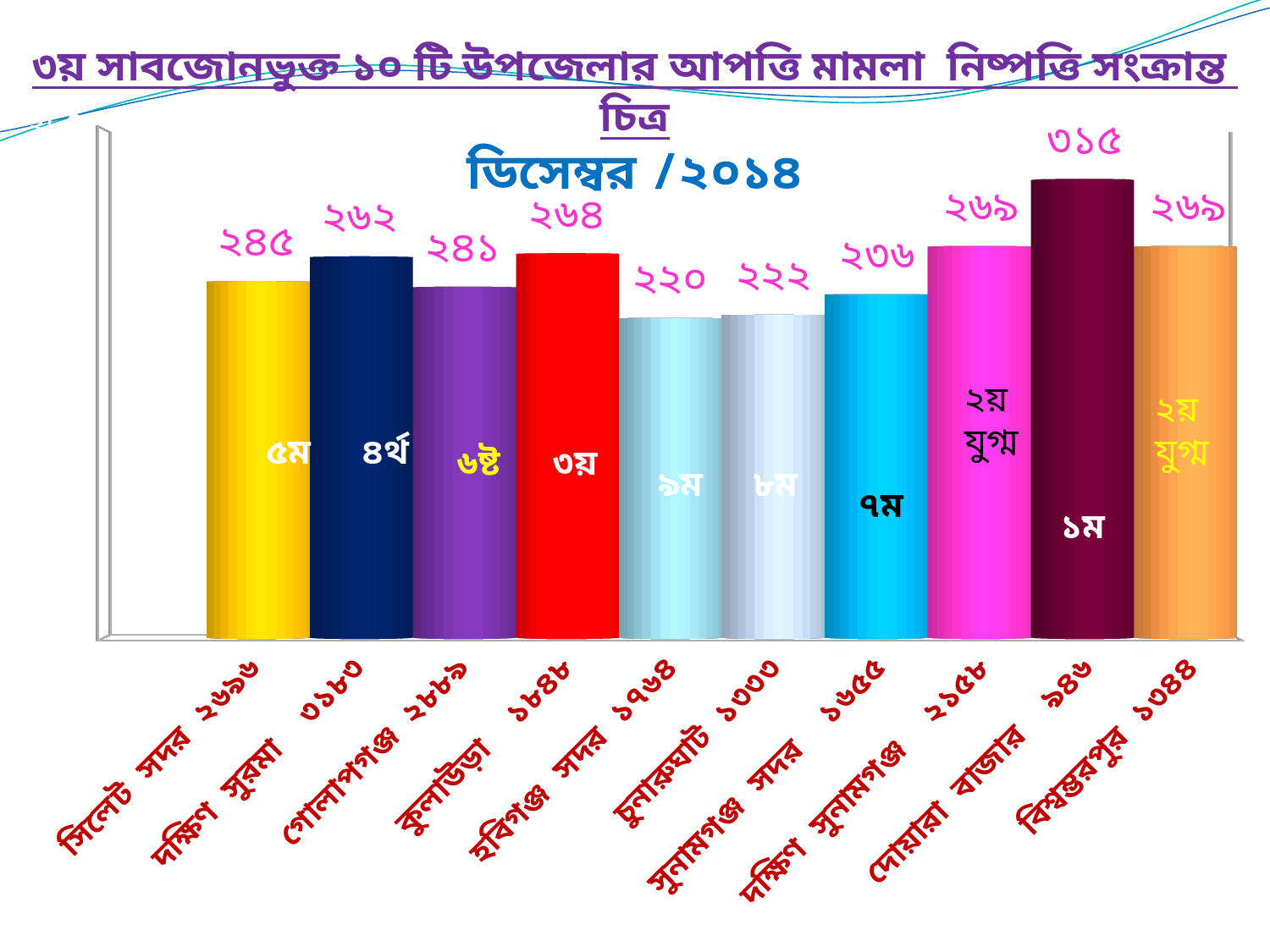
What is the difference between the values for দোয়ারা বাজার and হবিগঞ্জ সদর? ৯৫ How many categories (bars) are shown in the chart? 10 What rank label is printed inside the bar for দোয়ারা বাজার? ১ম Which category has the highest value? দোয়ারা বাজার What is the value shown for সুনামগঞ্জ সদর? ২৩৬ Which has the larger value, দক্ষিণ সুরমা or গোলাপগঞ্জ? দক্ষিণ সুরমা Which category has the lowest value? হবিগঞ্জ সদর What kind of chart is shown on the slide? bar chart What is the value shown for সিলেট সদর? ২৪৫ What is the value shown for কুলাউড়া? ২৬৪ What is the title printed above the bars of the chart? ডিসেম্বর /২০১৪ What is the value shown for বিশ্বম্ভরপুর? ২৬৯